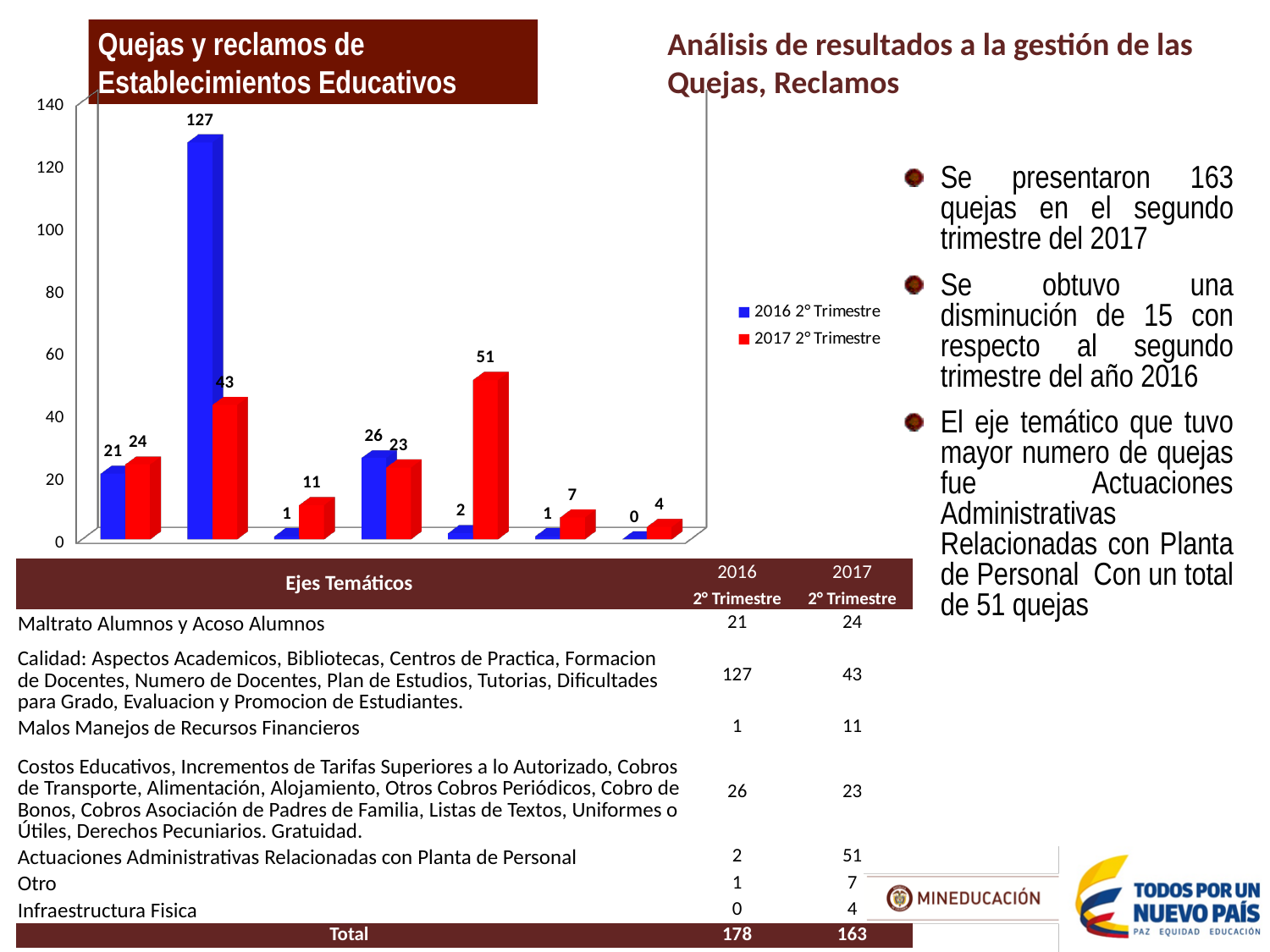
What is the highest value plotted for the 2017 2° Trimestre series? 51 What kind of chart is shown on the slide? bar chart What is the 2017 2° Trimestre value for Malos Manejos de Recursos Financieros? 11 What are the two series named in the chart legend? 2016 2° Trimestre and 2017 2° Trimestre What is the lowest value plotted for the 2016 2° Trimestre series? 0 What is the difference between the 2016 2° Trimestre value (127) and the 2017 2° Trimestre value (43) for the Calidad category? 84 How many series does the chart legend list? 2 For Actuaciones Administrativas Relacionadas con Planta de Personal, which series has the larger value, 2016 2° Trimestre or 2017 2° Trimestre? 2017 2° Trimestre What is the title of the chart? Quejas y reclamos de Establecimientos Educativos What is the 2016 2° Trimestre value for Maltrato Alumnos y Acoso Alumnos? 21 How many categories (pairs of bars) are plotted in the chart? 7 What is the highest value plotted for the 2016 2° Trimestre series? 127